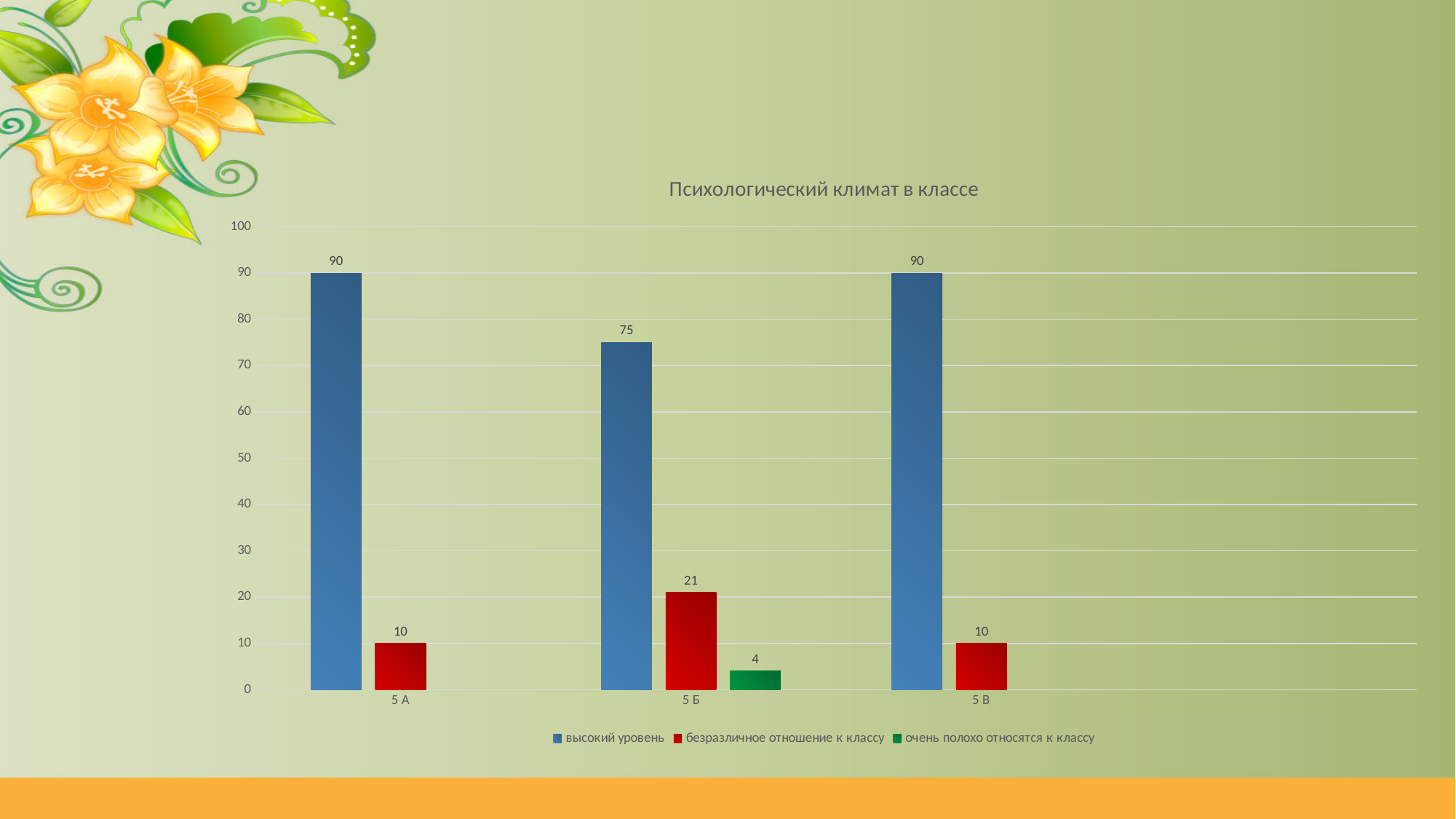
What type of chart is shown? bar chart What is the difference between the 'высокий уровень' values for 5 А and 5 Б? 15 Which class has the lowest value for 'высокий уровень'? 5 Б Which is larger: 'безразличное отношение к классу' for 5 Б or for 5 В? 5 Б How many classes are shown on the x axis? 3 What is the title of the chart? Психологический климат в классе What is the value of 'безразличное отношение к классу' for 5 А? 10 How many series does the legend list? 3 What is the value of 'очень полохо относятся к классу' for 5 Б? 4 What is the value of 'безразличное отношение к классу' for 5 Б? 21 Which class has the highest value for 'безразличное отношение к классу'? 5 Б What is the value of 'высокий уровень' for 5 Б? 75